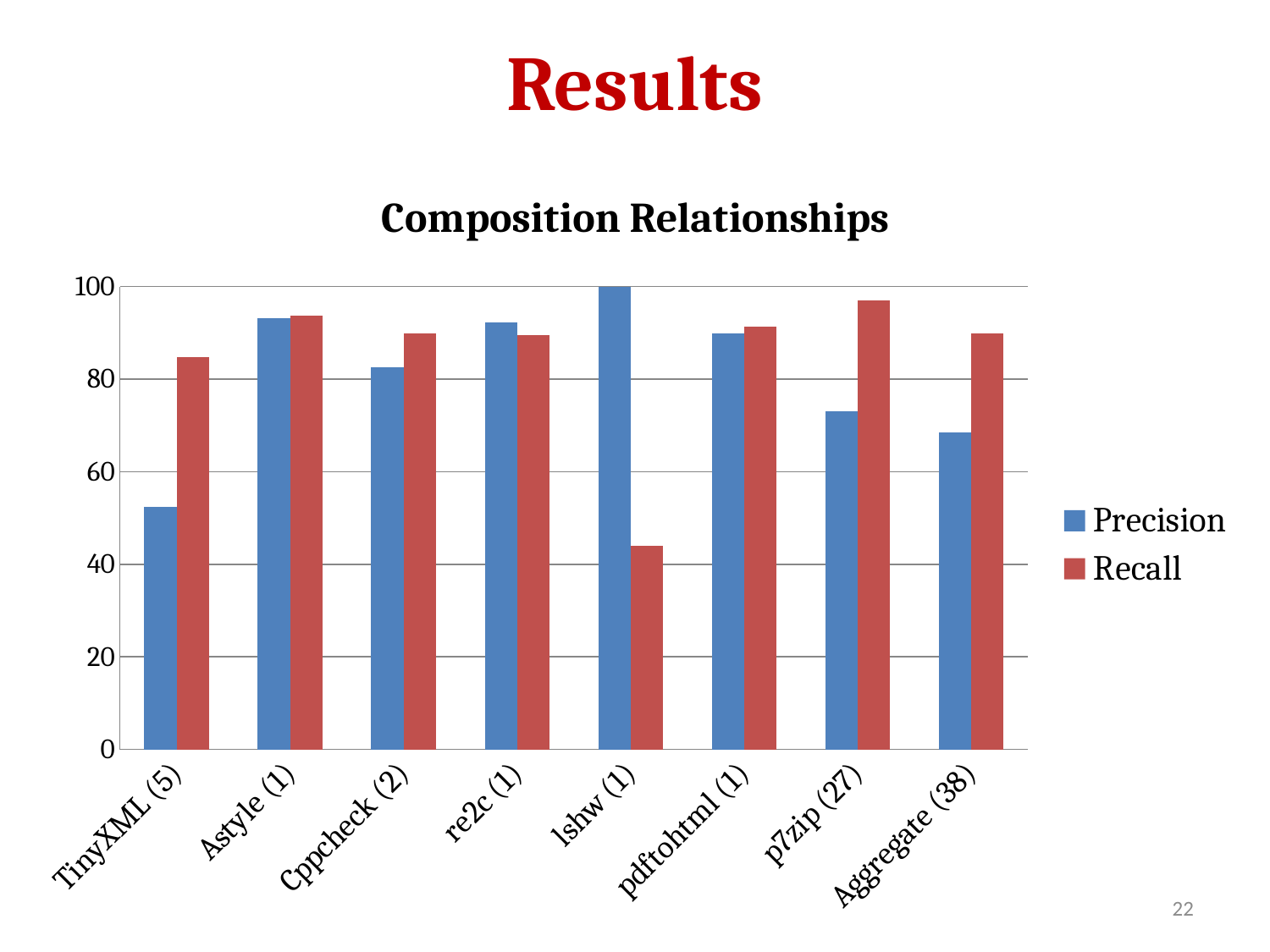
Which category has the lowest Precision value? TinyXML (5) Which category has the lowest Recall value? lshw (1) For lshw (1), which is larger, Precision or Recall? Precision How many categories are shown on the x axis? 8 Is the Precision value for TinyXML (5) greater or less than 60? less Is the Recall value for lshw (1) greater or less than 60? less What kind of chart is shown on the slide? bar chart Is the Precision value for p7zip (27) greater or less than 60? greater What is the title of the chart? Composition Relationships Which category has the highest Precision value? lshw (1) For TinyXML (5), which is larger, Precision or Recall? Recall How many series does the legend list? 2